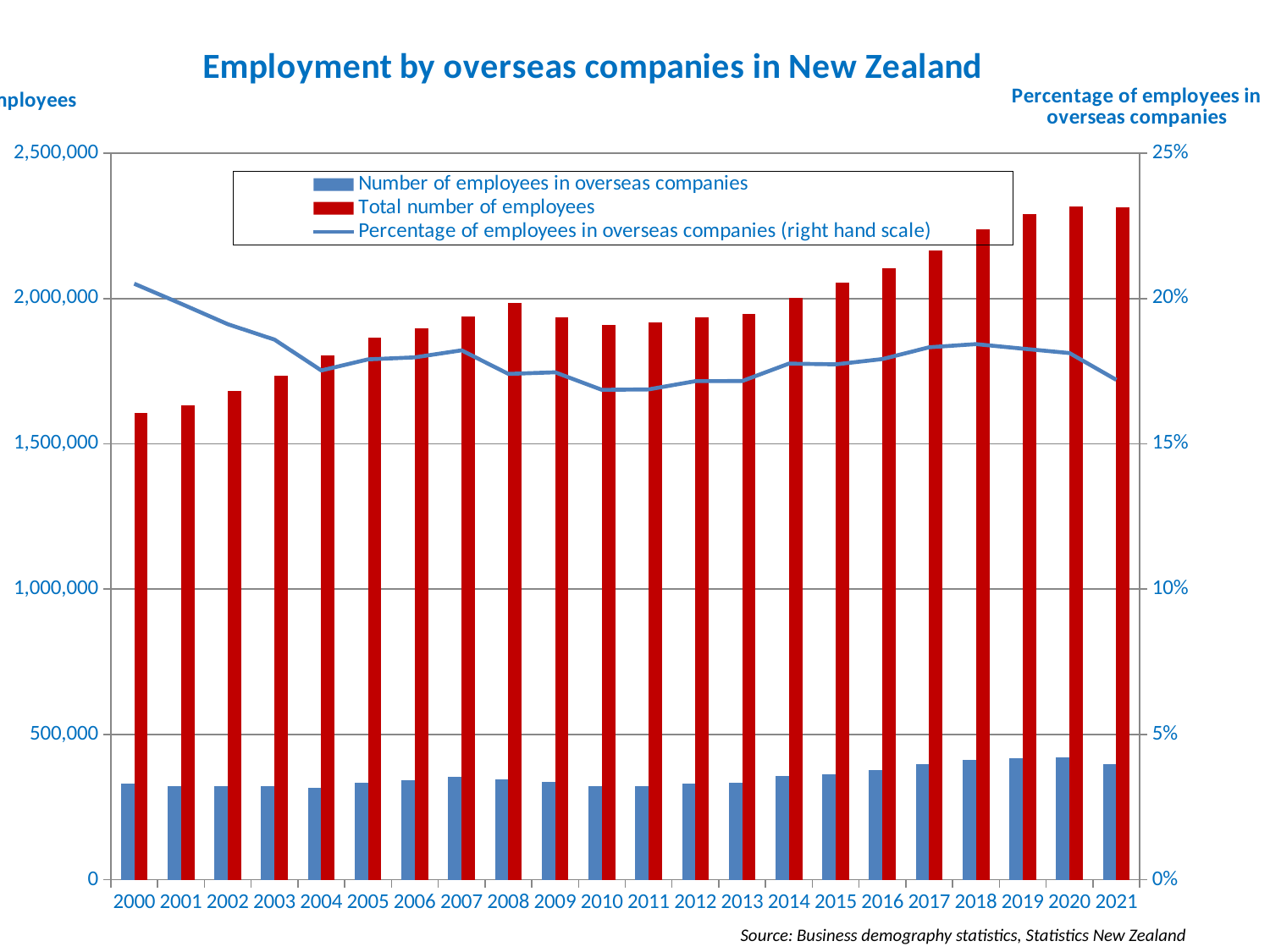
Which year has the lowest total number of employees? 2000 How many series does the legend list? 3 Which is larger, the total number of employees in 2008 or in 2010? 2008 Which year has the highest percentage of employees in overseas companies? 2000 How many years are shown on the x axis? 22 Is the total number of employees in 2021 greater or less than 2,000,000? greater What kind of chart is used to show the total number of employees? bar chart What is the title of the chart? Employment by overseas companies in New Zealand Is the number of employees in overseas companies in 2010 greater or less than 500,000? less Is the percentage of employees in overseas companies in 2021 greater or less than 20%? less Does the total number of employees generally rise or fall from 2000 to 2021? rise What colour are the bars for the total number of employees? red